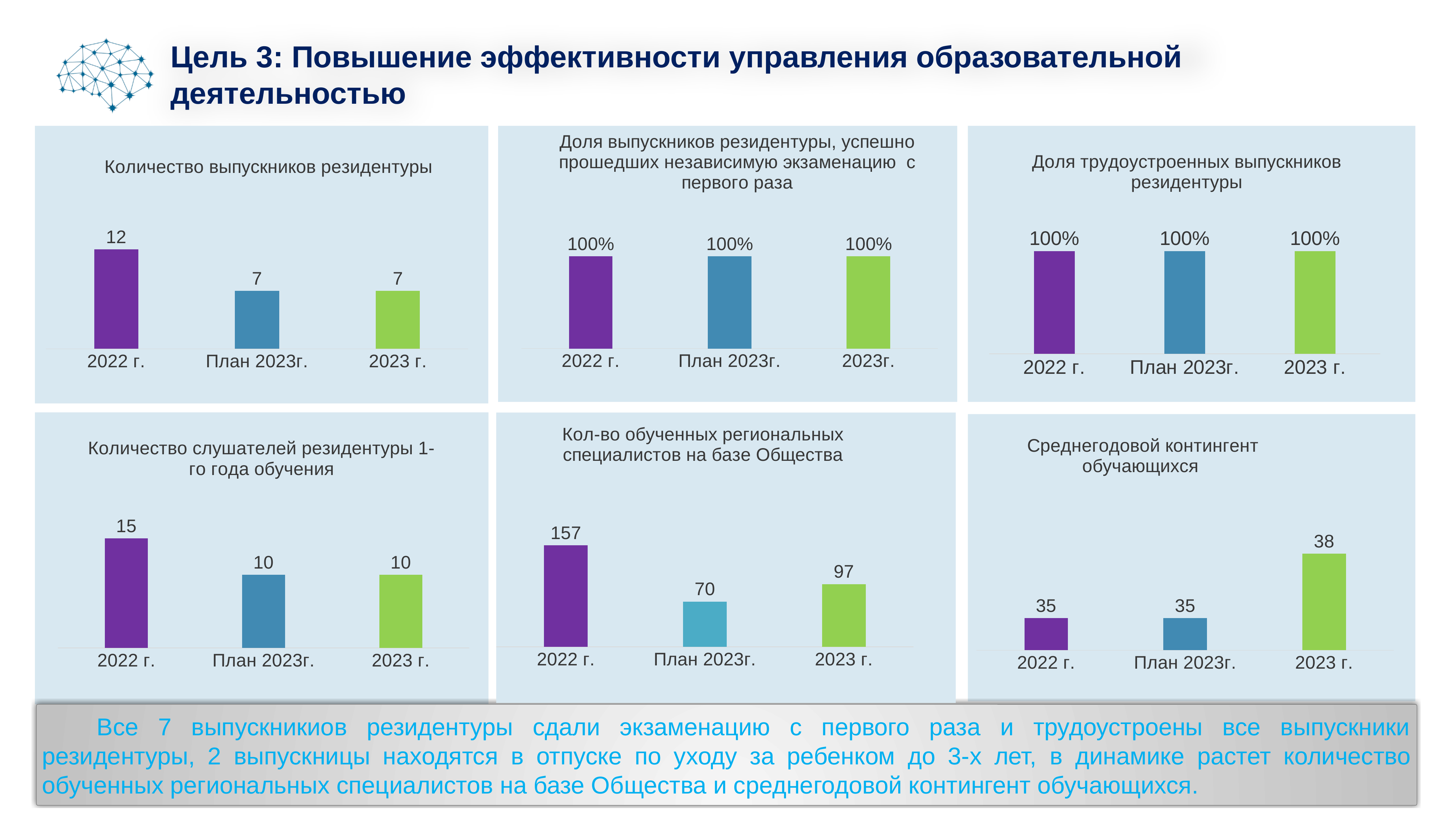
In the chart titled "Среднегодовой контингент обучающихся", which is larger: the value for План 2023г. or the value for 2023 г.? 2023 г. In the chart titled "Доля трудоустроенных выпускников резидентуры", how many categories are shown on the x axis? 3 In the chart titled "Количество выпускников резидентуры", what is the value for 2022 г.? 12 In the chart titled "Количество слушателей резидентуры 1-го года обучения", which category has the highest value? 2022 г. In the chart titled "Количество выпускников резидентуры", what is the value for План 2023г.? 7 In the chart titled "Количество выпускников резидентуры", what is the difference between the 2022 г. value and the 2023 г. value? 5 In the chart titled "Количество слушателей резидентуры 1-го года обучения", what is the value for 2023 г.? 10 In the chart titled "Кол-во обученных региональных специалистов на базе Общества", what is the value for План 2023г.? 70 In the chart titled "Кол-во обученных региональных специалистов на базе Общества", which category has the lowest value? План 2023г. In the chart titled "Кол-во обученных региональных специалистов на базе Общества", what is the difference between the 2022 г. value and the 2023 г. value? 60 In the chart titled "Доля выпускников резидентуры, успешно прошедших независимую экзаменацию с первого раза", what is the value for 2023г.? 100% What type of chart is the one titled "Среднегодовой контингент обучающихся"? Bar chart